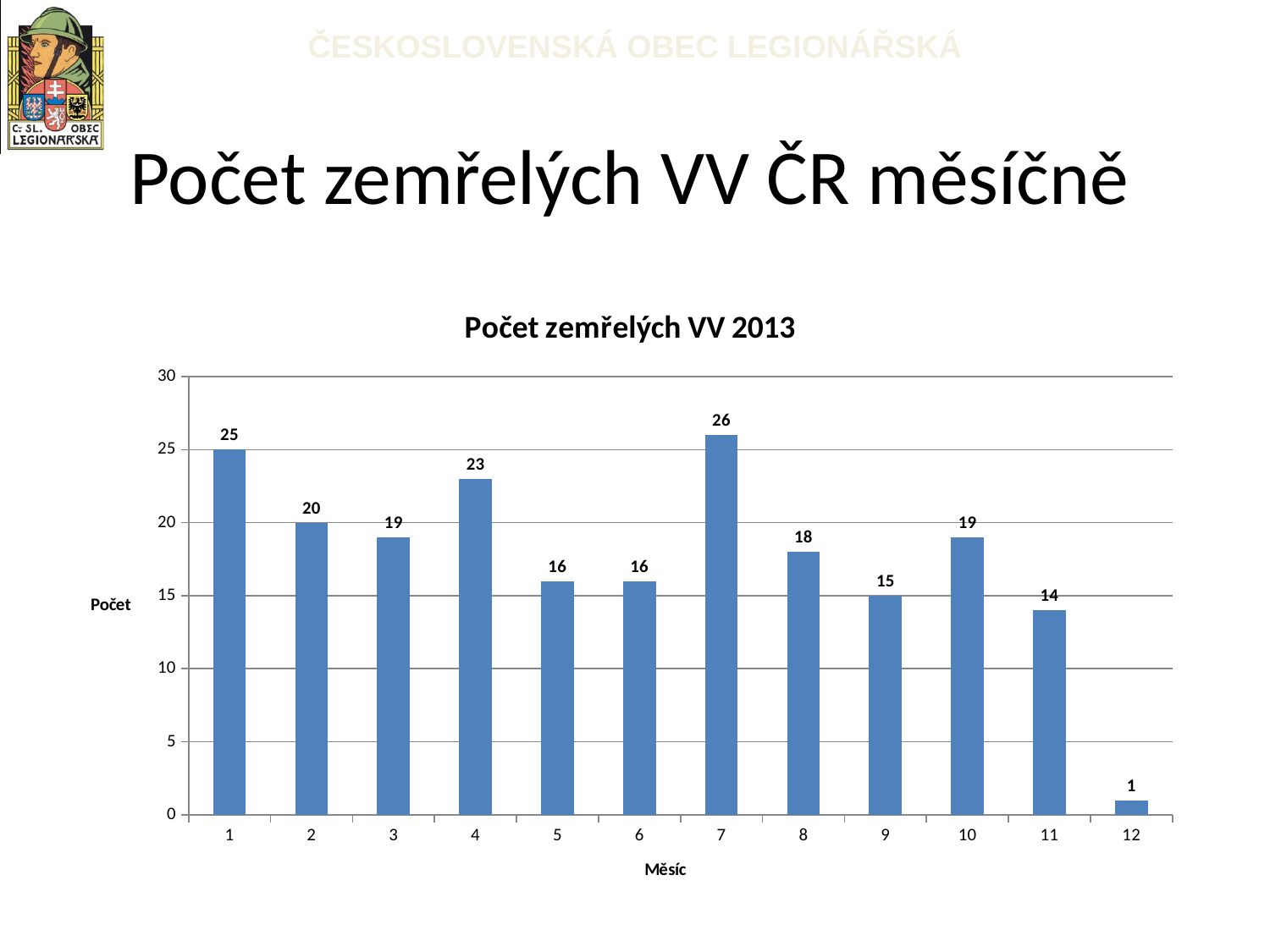
What is the label of the x axis? Měsíc Which month has the highest value? 7 What kind of chart is this? bar chart Which month has the lowest value? 12 What is the value for month 4? 23 Which is larger, the value for month 8 or the value for month 9? month 8 Is the value for month 11 greater or less than 15? less What is the title of the chart? Počet zemřelých VV 2013 How many months are shown on the x axis? 12 What is the value for month 7? 26 What is the value for month 12? 1 What is the difference between the values for month 1 and month 2? 5